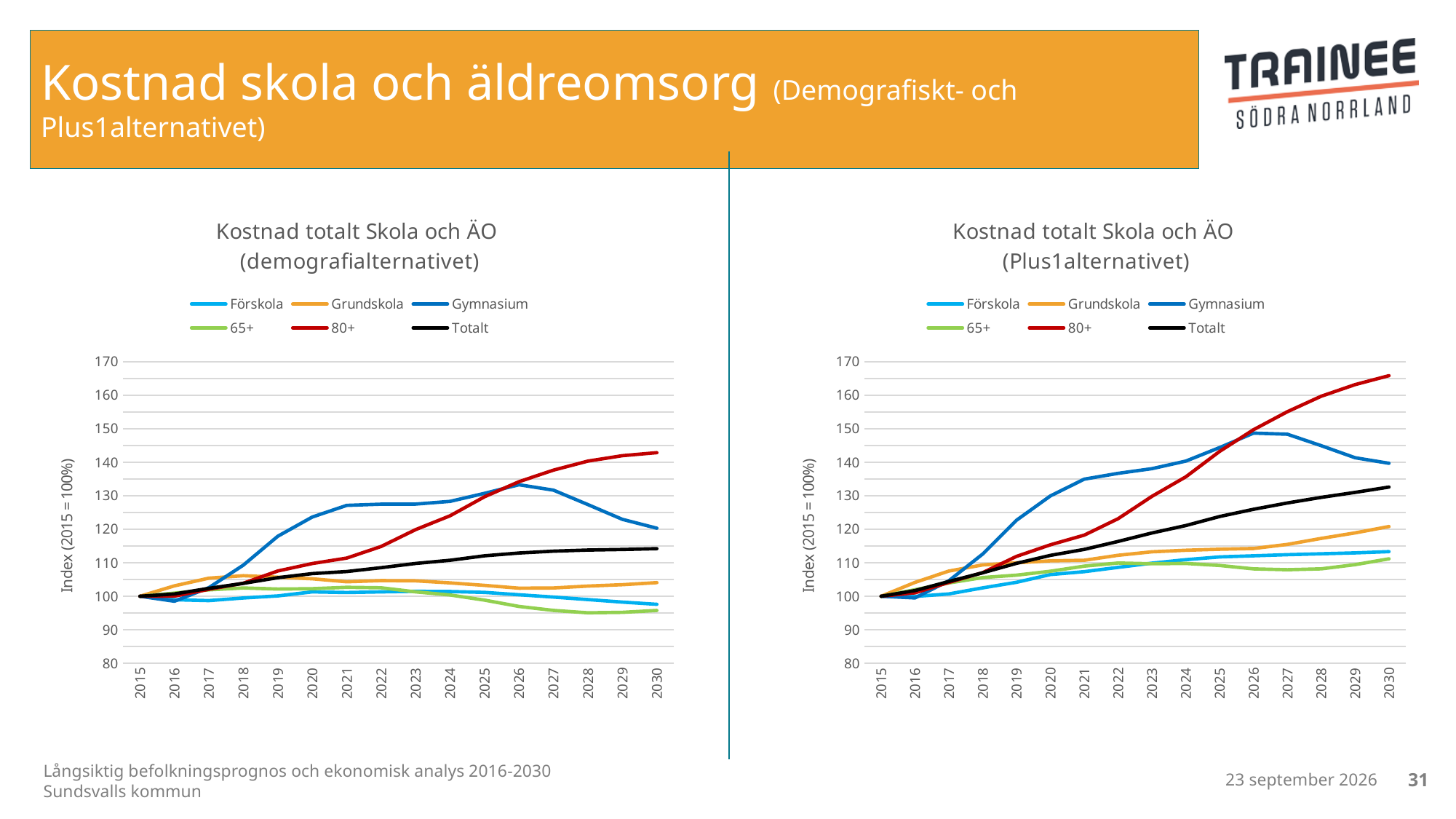
What is the y-axis label of the left chart (demografialternativet)? Index (2015 = 100%) In the right chart (Plus1alternativet), which is larger in 2030: Gymnasium or Totalt? Gymnasium What kind of chart is the left chart, 'Kostnad totalt Skola och ÄO (demografialternativet)'? line chart How many series does the legend of the right chart, 'Kostnad totalt Skola och ÄO (Plus1alternativet)', list? 6 In the left chart (demografialternativet), is the value for 80+ in 2030 greater or less than 140? greater In the left chart (demografialternativet), is the value for 65+ in 2030 greater or less than 100? less In the right chart (Plus1alternativet), which series has the highest value in 2030? 80+ In the right chart (Plus1alternativet), does the 80+ series rise or fall from 2015 to 2030? rise In the right chart (Plus1alternativet), is the value for Totalt in 2030 greater or less than 130? greater How many years are plotted along the x axis of the left chart (demografialternativet)? 16 In the left chart (demografialternativet), which series has the lowest value in 2030? 65+